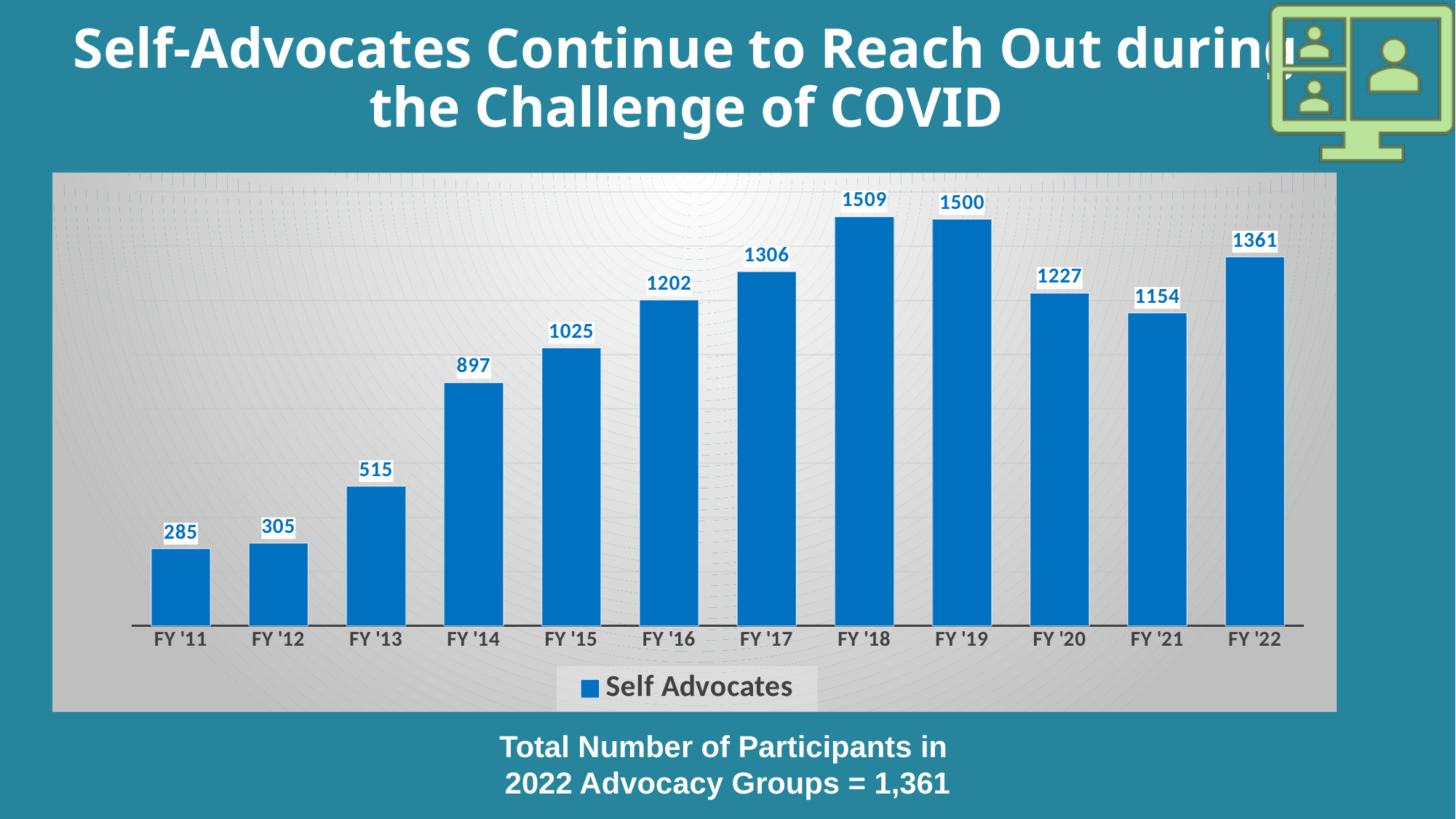
Which is larger, the value for FY '17 or the value for FY '20? FY '17 What is the value for FY '11? 285 What kind of chart is shown on the slide? Bar chart Do the values rise or fall from FY '11 to FY '18? Rise What is the difference between the values for FY '22 and FY '21? 207 What series name is shown in the legend? Self Advocates What is the value for FY '18? 1509 Which fiscal year has the highest value? FY '18 How many series does the legend list? 1 What is the value for FY '22? 1361 How many fiscal years are shown on the x axis? 12 Which fiscal year has the lowest value? FY '11